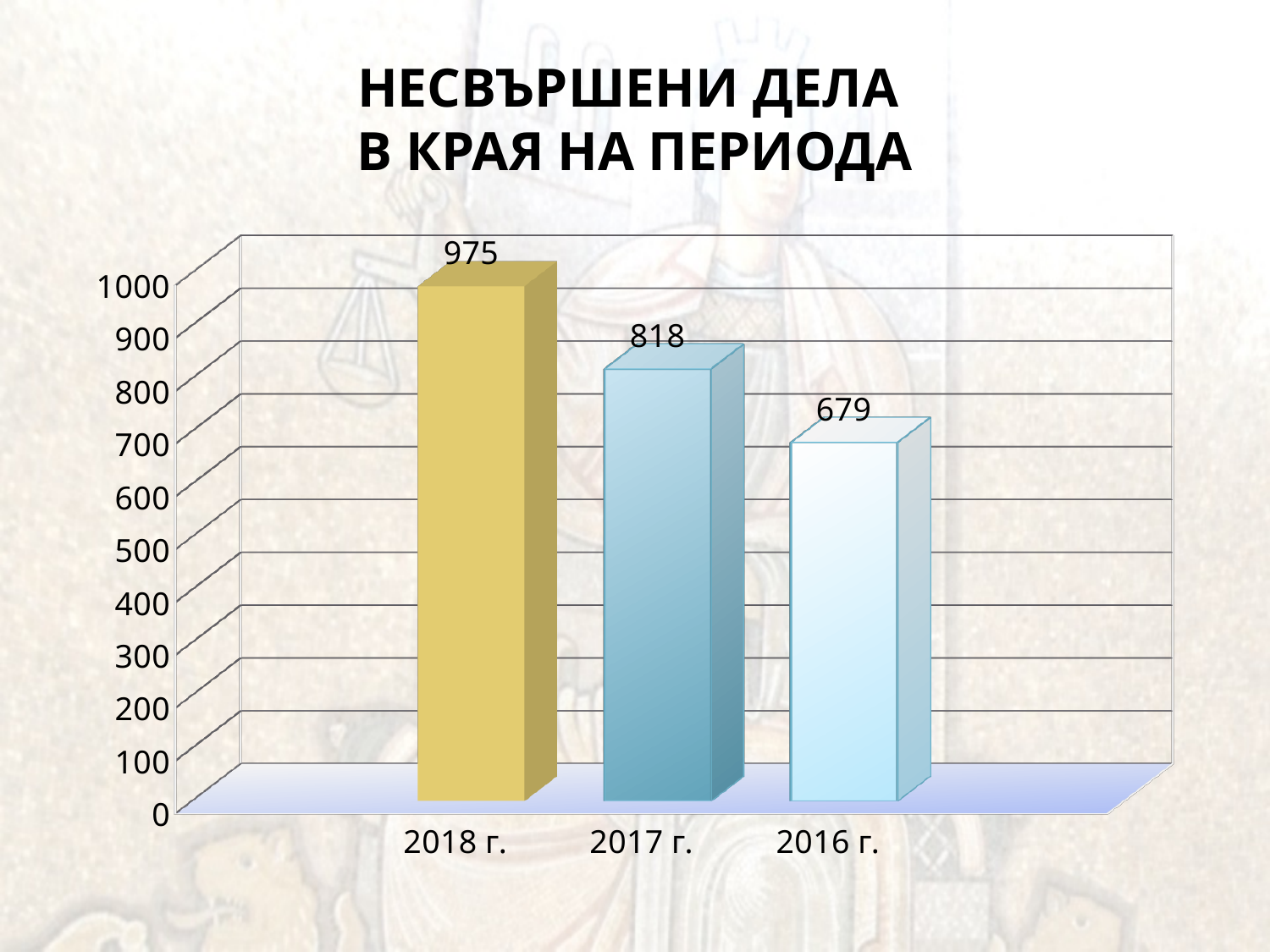
How many categories are shown on the x axis? 3 What is the value for 2016 г.? 679 What kind of chart is shown on the slide? bar chart What is the difference between the values for 2018 г. and 2017 г.? 157 Is the value for 2016 г. greater or less than 700? less What is the difference between the values for 2017 г. and 2016 г.? 139 What is the value for 2018 г.? 975 Which year has the lowest value? 2016 г. Which is larger, the value for 2018 г. or the value for 2016 г.? 2018 г. Which year has the highest value? 2018 г. What is the title of the chart? НЕСВЪРШЕНИ ДЕЛА В КРАЯ НА ПЕРИОДА What is the value for 2017 г.? 818